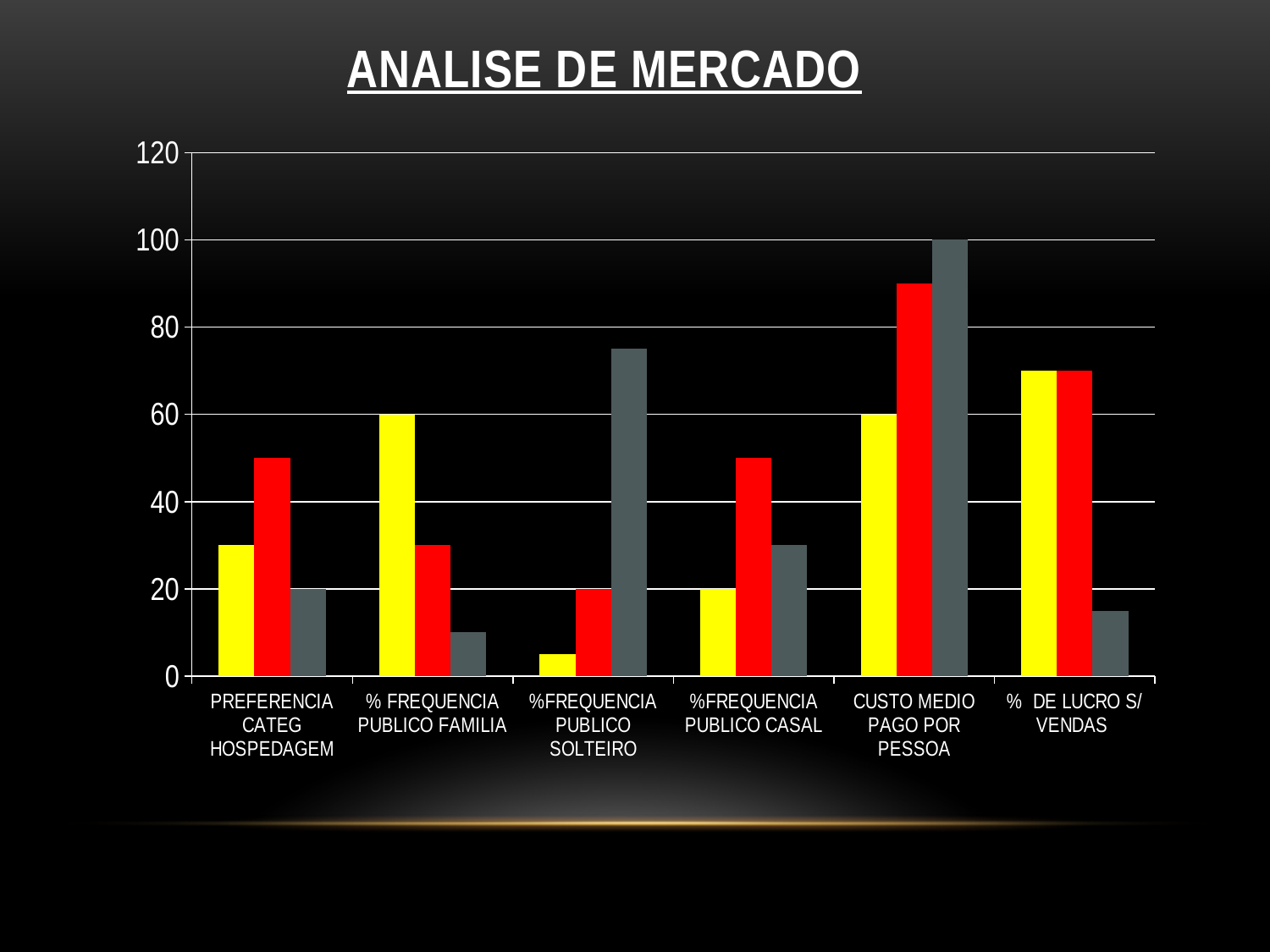
What is the value of the yellow bar for % FREQUENCIA PUBLICO FAMILIA? 60 Which category has the shortest yellow bar? %FREQUENCIA PUBLICO SOLTEIRO Which category has the tallest bar in the chart? CUSTO MEDIO PAGO POR PESSOA Which is larger for PREFERENCIA CATEG HOSPEDAGEM, the yellow bar or the red bar? the red bar What is the value of the gray bar for CUSTO MEDIO PAGO POR PESSOA? 100 What is the value of the yellow bar for %FREQUENCIA PUBLICO CASAL? 20 What is the difference between the gray bar for CUSTO MEDIO PAGO POR PESSOA and the yellow bar for CUSTO MEDIO PAGO POR PESSOA? 40 How many categories are shown on the x axis of the chart? 6 Is the value of the gray bar for %FREQUENCIA PUBLICO SOLTEIRO greater or less than 60? greater What is the title of the slide containing the chart? ANALISE DE MERCADO What kind of chart is shown on the slide? bar chart Is the value of the red bar for CUSTO MEDIO PAGO POR PESSOA greater or less than 80? greater